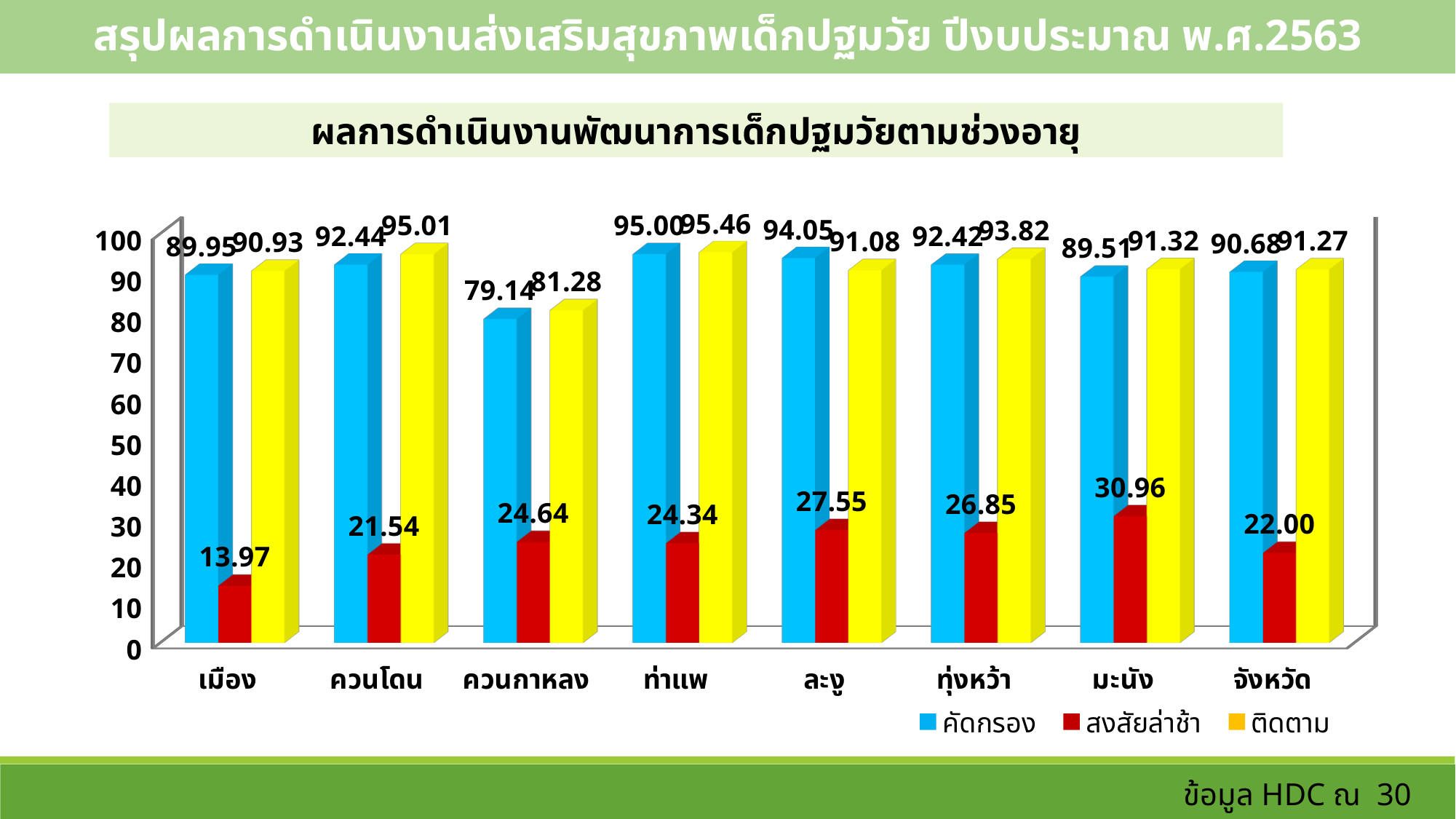
What is the สงสัยล่าช้า value for มะนัง? 30.96 Which category has the lowest สงสัยล่าช้า value? เมือง What kind of chart is shown on the slide? Bar chart What is the สงสัยล่าช้า value for จังหวัด? 22.00 How many series does the legend list? 3 What is the คัดกรอง value for ควนกาหลง? 79.14 What is the ติดตาม value for ควนโดน? 95.01 Which is larger for ละงู, the คัดกรอง value or the ติดตาม value? คัดกรอง Which category has the highest สงสัยล่าช้า value? มะนัง What is the difference between the ติดตาม and คัดกรอง values for ควนโดน? 2.57 How many categories are shown on the x axis? 8 Which category has the lowest คัดกรอง value? ควนกาหลง